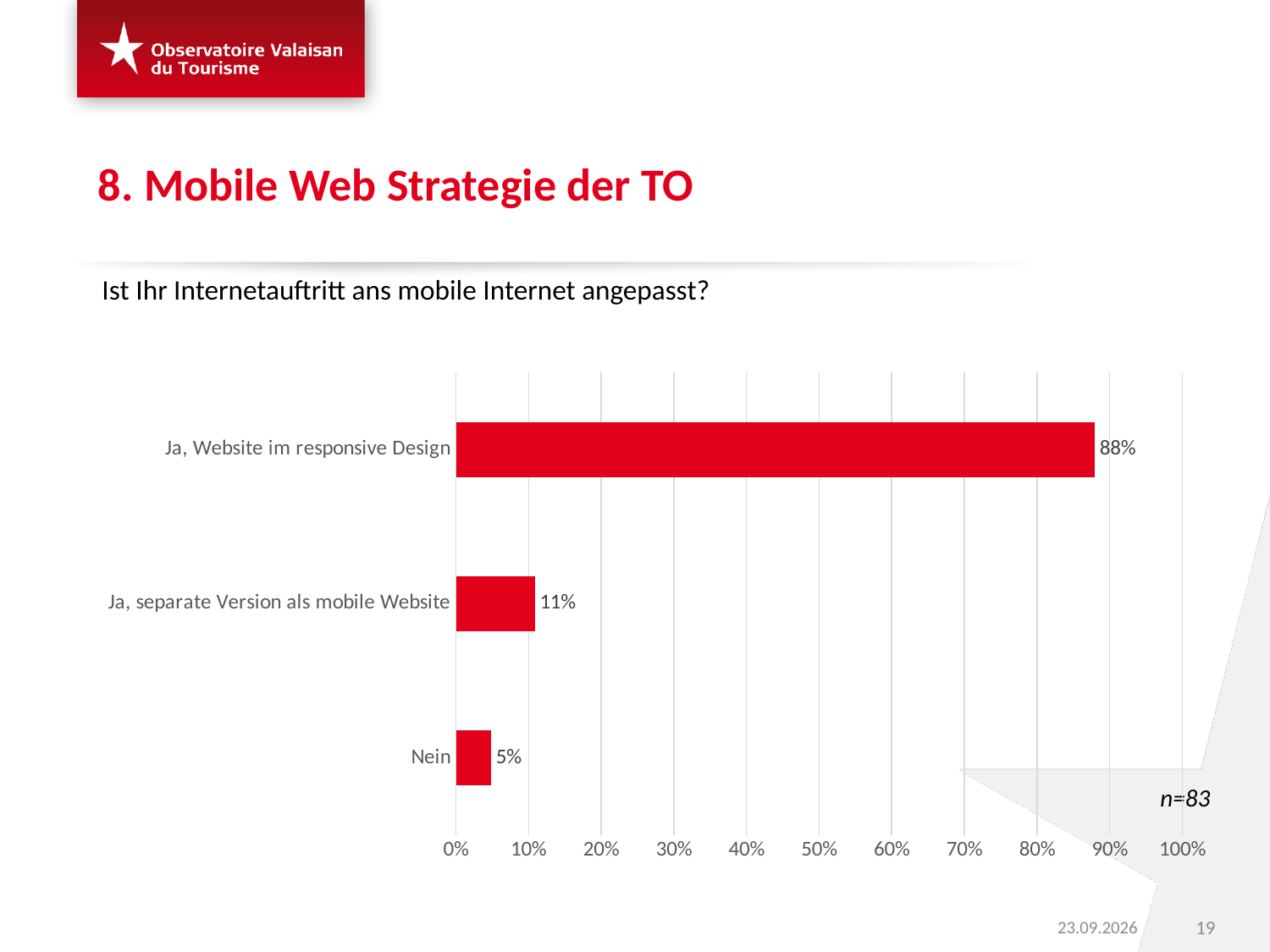
What is the difference between "Ja, separate Version als mobile Website" and "Nein"? 6% What percentage of respondents answered "Nein"? 5% Which is larger: the value for "Ja, separate Version als mobile Website" or for "Nein"? Ja, separate Version als mobile Website What sample size (n) is indicated on the slide? n=83 What percentage of respondents answered "Ja, Website im responsive Design"? 88% What is the difference between "Ja, Website im responsive Design" and "Ja, separate Version als mobile Website"? 77% What kind of chart is shown on the slide? Bar chart Which category has the lowest value? Nein What is the value for "Ja, separate Version als mobile Website"? 11% Which category has the highest value? Ja, Website im responsive Design Is the value for "Ja, Website im responsive Design" greater or less than 80%? greater How many categories are shown in the chart? 3